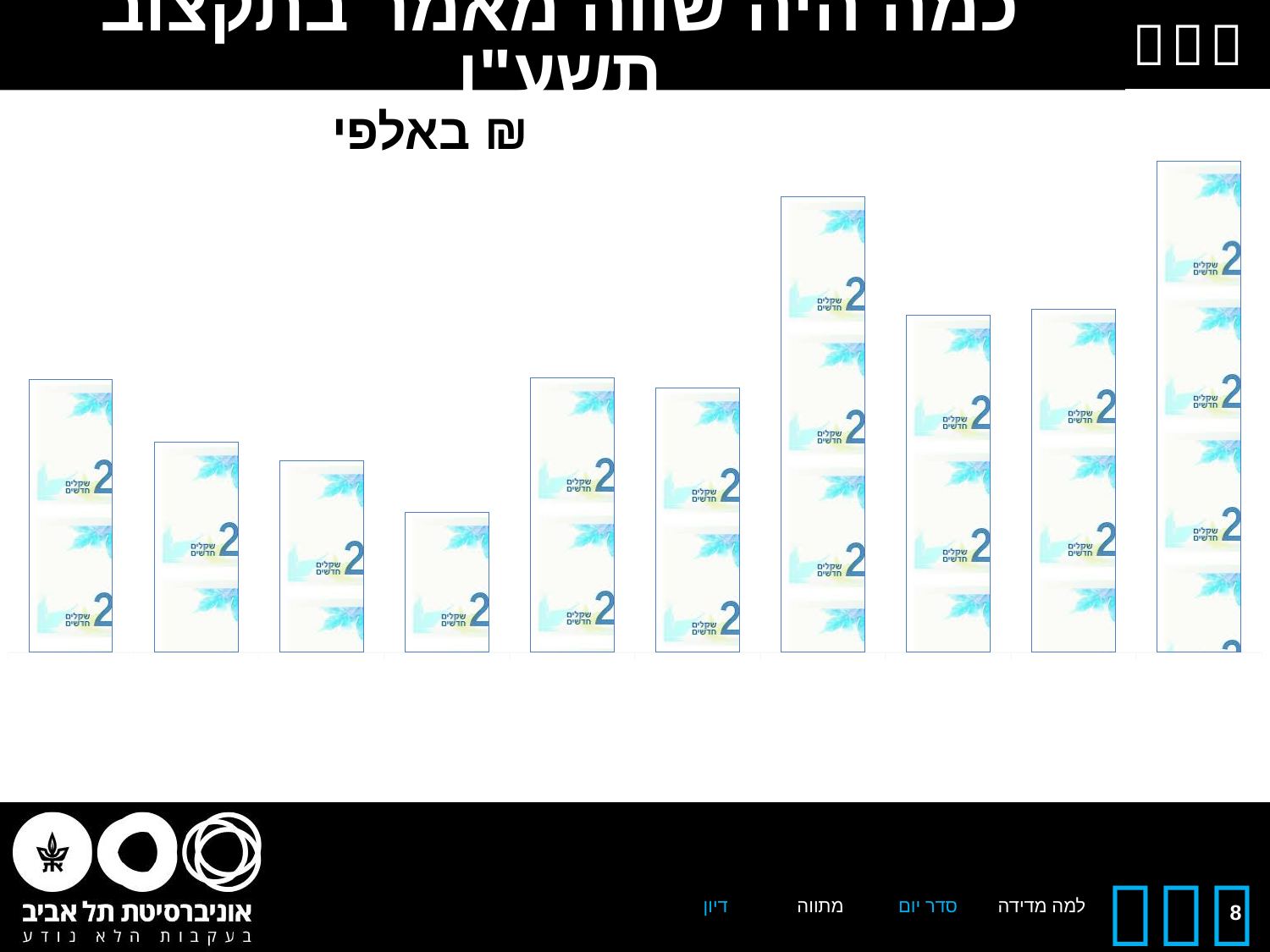
Which is taller, the 5th bar from the left or the 6th bar from the left? the 5th bar from the left What image is used to fill the bars of the chart? 20 new shekel banknotes What kind of chart is shown on the slide? bar chart Which bar is the tallest in the chart? the rightmost bar (10th from left) Do the bar heights rise or fall from the 1st bar to the 4th bar from the left? fall How many bars does the chart contain? 10 Which is taller, the 7th bar from the left or the 8th bar from the left? the 7th bar from the left What unit label is shown above the chart? באלפי ₪ Which is taller, the 1st bar from the left or the 4th bar from the left? the 1st bar from the left Do the bar heights rise or fall from the 4th bar to the 7th bar from the left? rise Which bar is the shortest in the chart? the 4th bar from the left